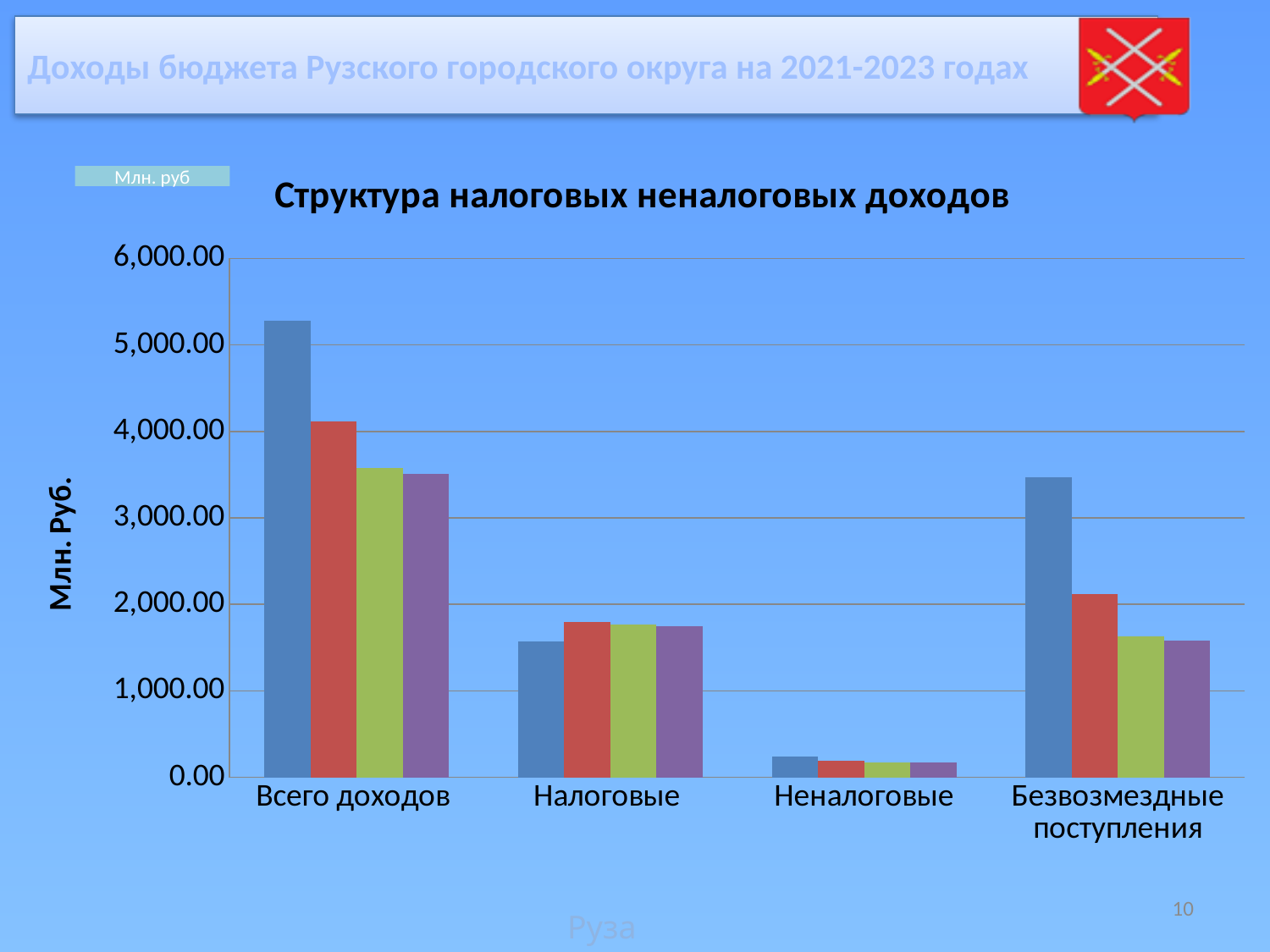
For the blue bars, which is larger: Налоговые or Безвозмездные поступления? Безвозмездные поступления What type of chart is shown on the slide? bar chart What is the title of the chart? Структура налоговых неналоговых доходов Is the value of the tallest (blue) bar for Всего доходов greater or less than 5,000.00? greater Which category has the lowest bars in the chart? Неналоговые What is the label on the vertical axis of the chart? Млн. Руб. Are the values for Неналоговые greater or less than 1,000.00? less How many bars are shown for each category in the chart? 4 Which category has the tallest bar in the chart? Всего доходов Is the value of the blue bar for Безвозмездные поступления greater or less than 3,000.00? greater How many categories are shown on the x axis of the chart? 4